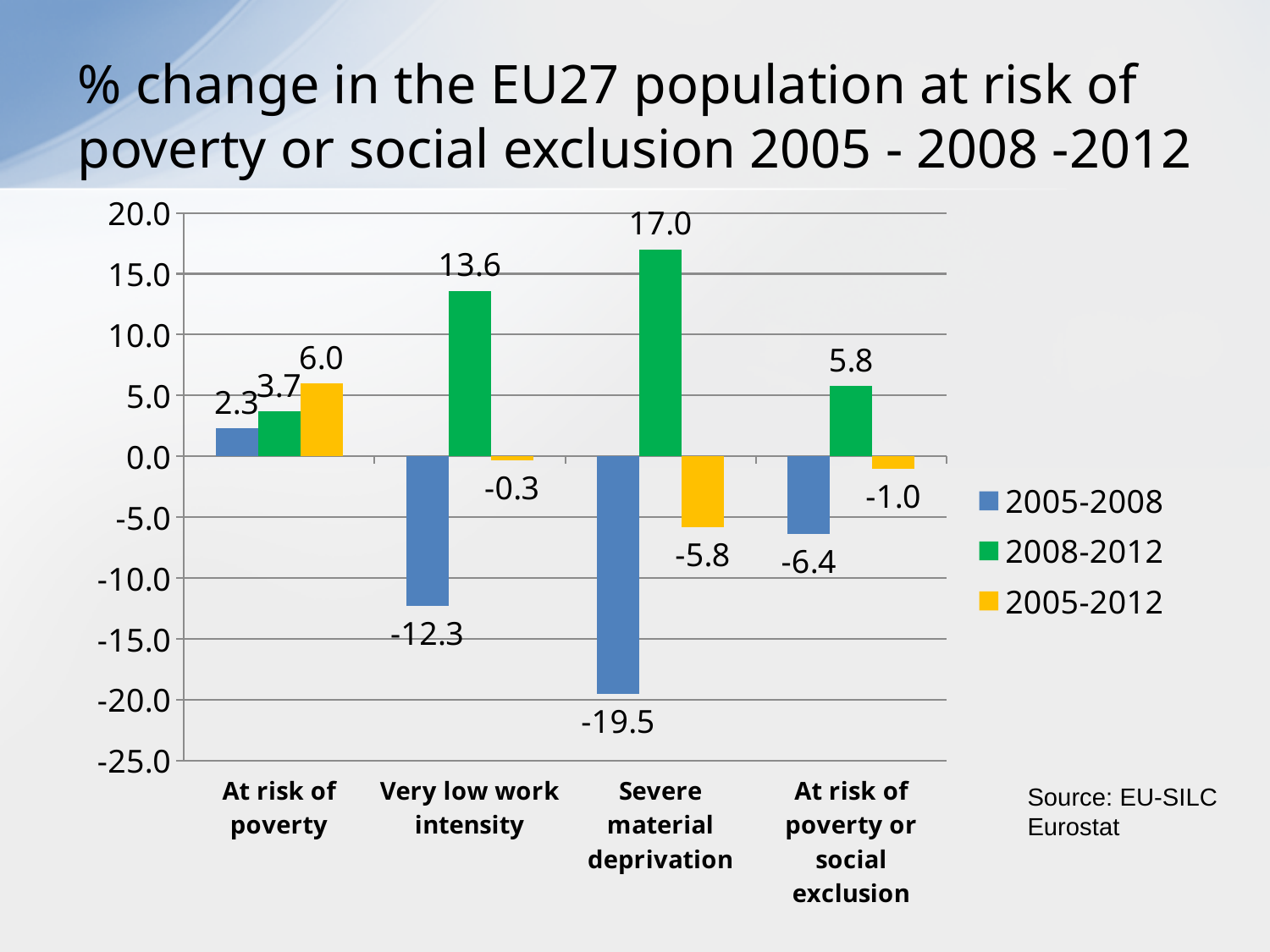
What is the 2005-2012 value for At risk of poverty or social exclusion? -1.0 What is the 2005-2008 value for Very low work intensity? -12.3 Which category has the highest 2008-2012 value? Severe material deprivation Which category has the lowest 2005-2008 value? Severe material deprivation Which is larger for At risk of poverty or social exclusion: the 2005-2008 value or the 2008-2012 value? 2008-2012 What kind of chart is shown on the slide? Bar chart What is the difference between the 2008-2012 values for Severe material deprivation and Very low work intensity? 3.4 How many series does the legend list? 3 What is the 2008-2012 value for Severe material deprivation? 17.0 How many categories are shown on the x axis? 4 What source is cited for the chart? EU-SILC Eurostat What is the 2005-2012 value for At risk of poverty? 6.0